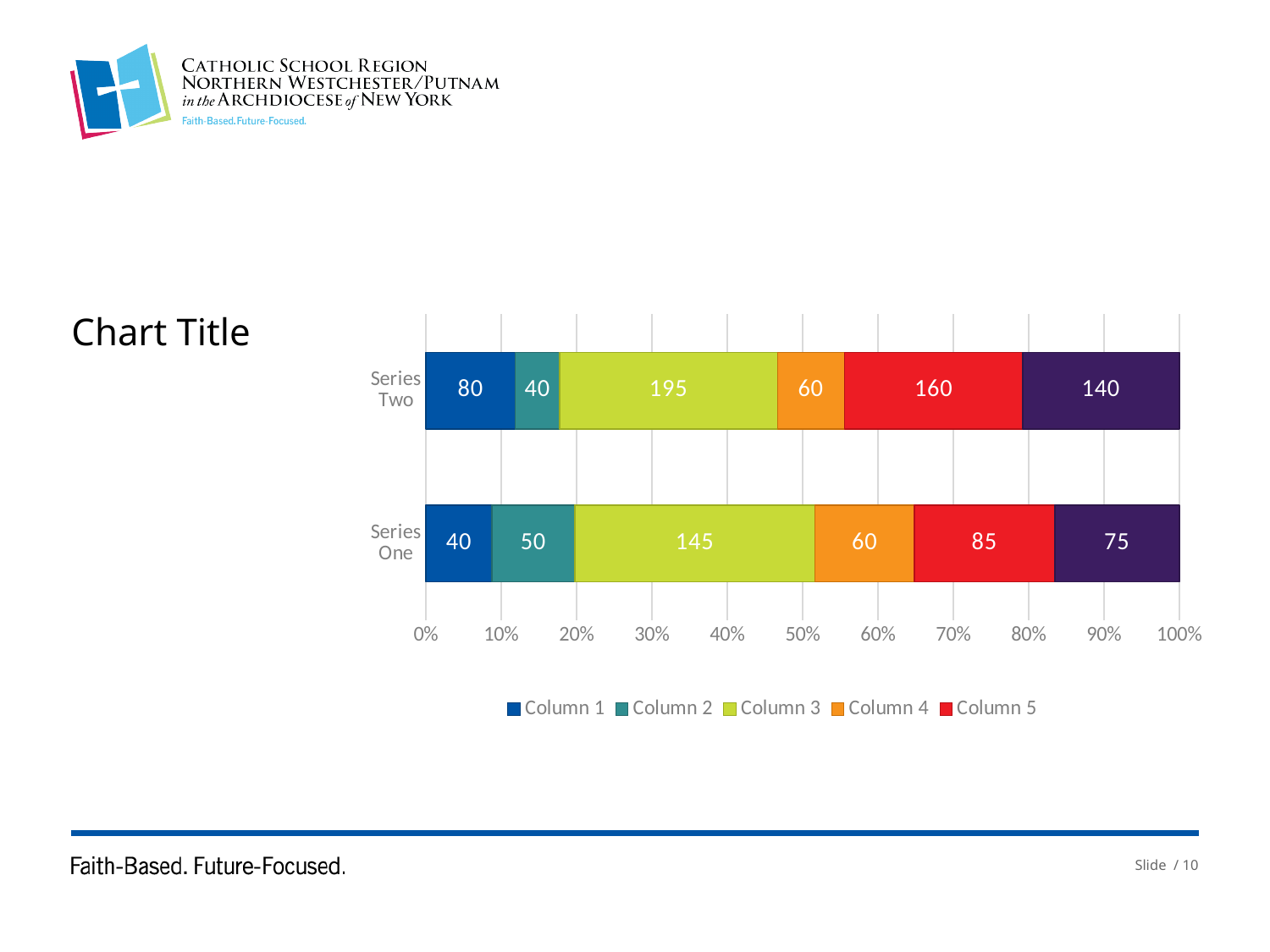
What kind of chart is shown on the slide? Stacked bar chart What is the value of Column 5 for Series Two? 160 How much larger is Column 3 for Series Two than for Series One? 50 What is the difference between Column 2 for Series One and Column 2 for Series Two? 10 How many series does the legend list? 5 What is the value of Column 3 for Series Two? 195 What is the total of all the labelled segments in the Series One bar? 455 What is the value of Column 4 for Series One? 60 What is the value of Column 1 for Series One? 40 Which has the larger Column 5 value, Series One or Series Two? Series Two Which legend column has the largest value in the Series One bar? Column 3 How many categories (bars) are shown on the chart? 2